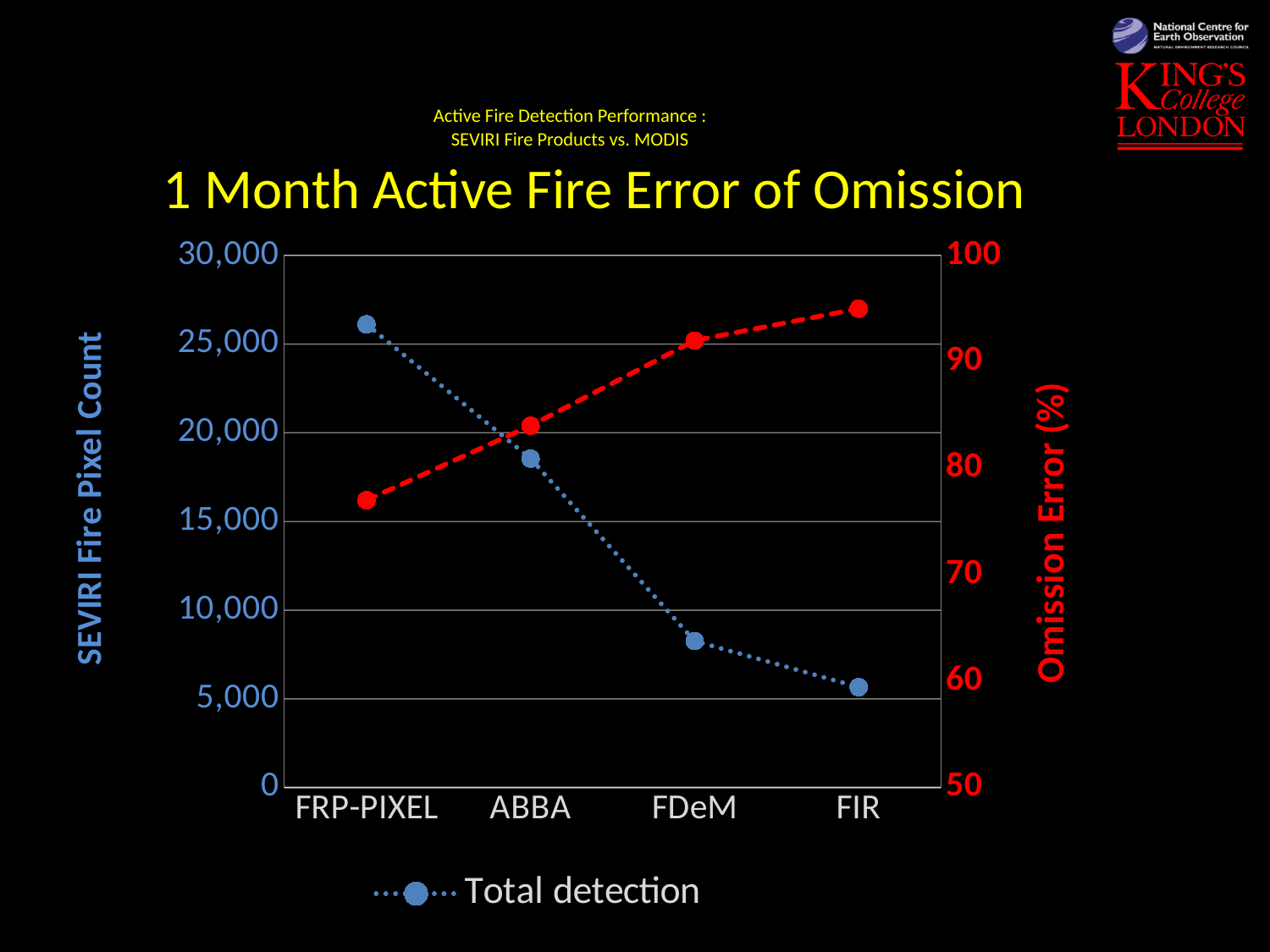
Which category has the highest Omission Error (%)? FIR Is the Total detection value for FDeM greater or less than 10,000? less Which category has the lowest Total detection (SEVIRI Fire Pixel Count)? FIR Is the Omission Error (%) for FRP-PIXEL greater or less than 80? less Does the Total detection series rise or fall from FRP-PIXEL to FIR? Fall How many categories are shown on the x axis of the chart? 4 Is the Total detection value for ABBA greater or less than 20,000? less Which has a higher Total detection, ABBA or FDeM? ABBA Which category has the lowest Omission Error (%)? FRP-PIXEL How many series does the chart's legend list? 1 Which category has the highest Total detection (SEVIRI Fire Pixel Count)? FRP-PIXEL What kind of chart is shown on the slide? Line chart